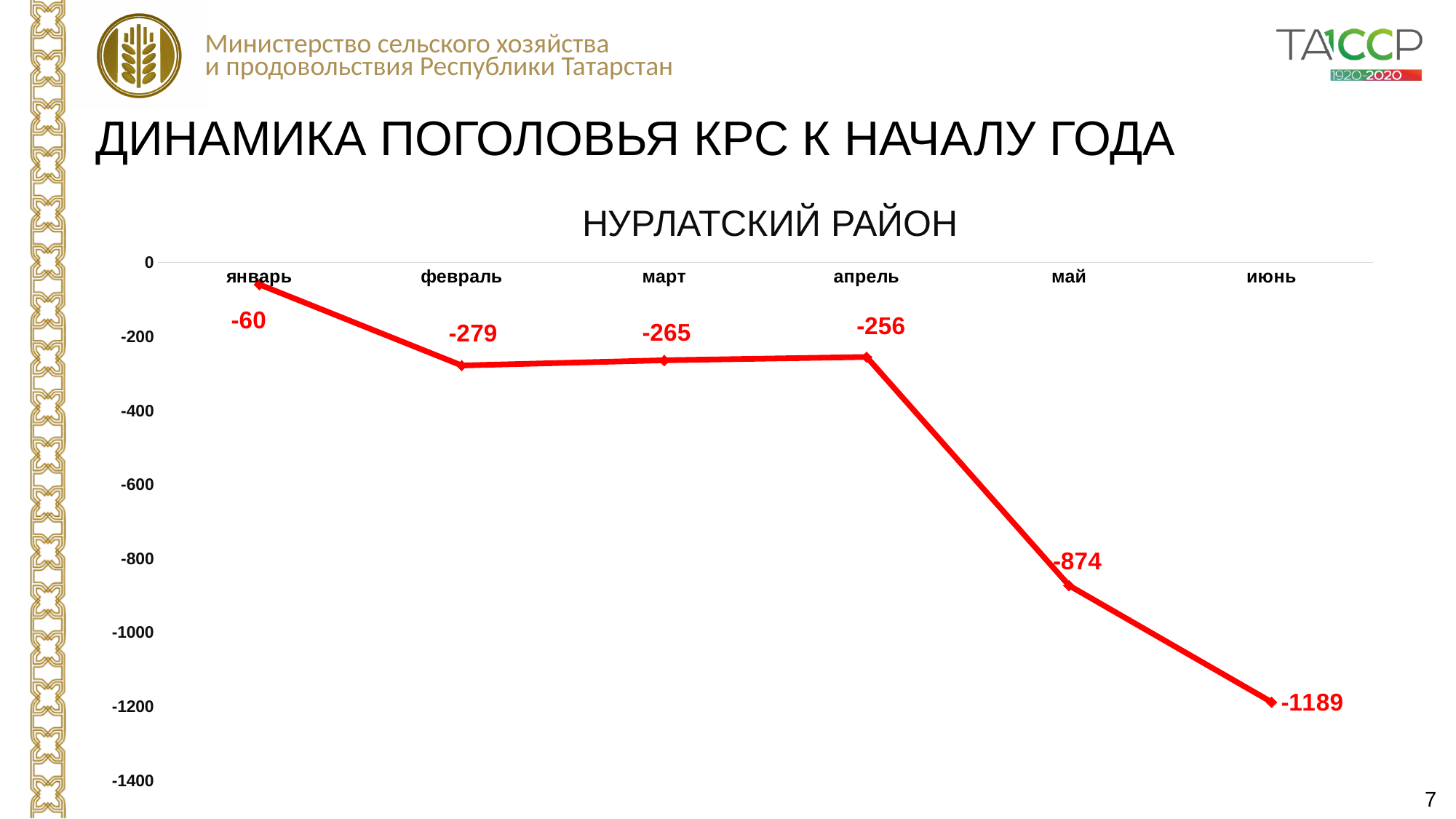
What is the difference between the values for январь and февраль? 219 What is the value for май? -874 Which month has the highest value? январь What is the value for январь? -60 What is the difference between the values for май and июнь? 315 What is the value for апрель? -256 Which is larger, the value for март or the value for февраль? март What is the value for июнь? -1189 What kind of chart is shown on the slide? line chart How many months are plotted on the chart? 6 Which month has the lowest value? июнь What is the title of the chart? НУРЛАТСКИЙ РАЙОН